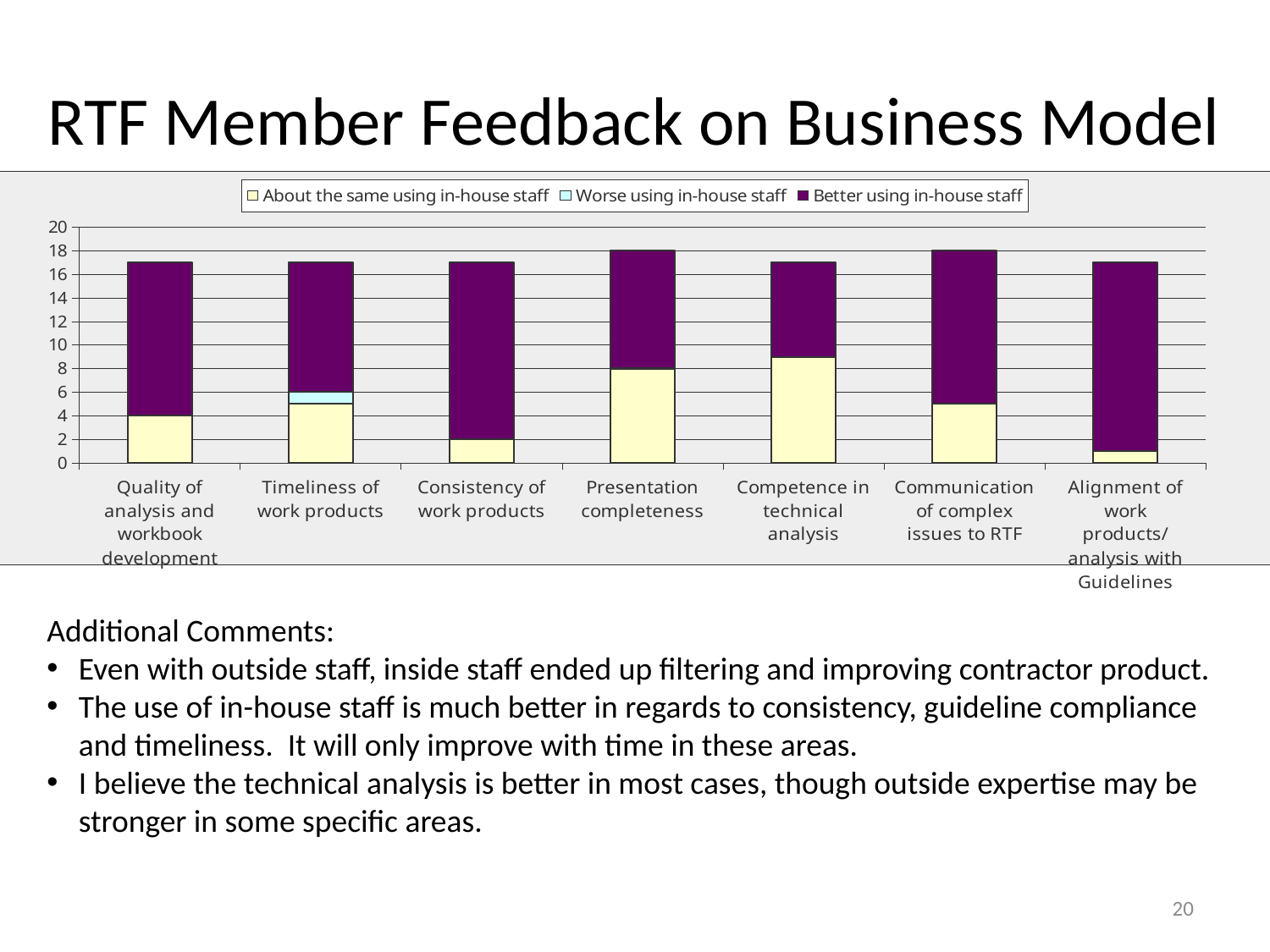
Which category has the lowest 'About the same using in-house staff' value? Alignment of work products/analysis with Guidelines Is the 'About the same using in-house staff' value for 'Competence in technical analysis' greater or less than 6? greater How many categories are shown along the x axis of the chart? 7 Which category is the only one with a 'Worse using in-house staff' segment? Timeliness of work products How many series does the chart legend list? 3 What type of chart is shown on the slide? Stacked bar chart What is the value of 'About the same using in-house staff' for 'Quality of analysis and workbook development'? 4 What is the value of 'About the same using in-house staff' for 'Consistency of work products'? 2 What is the total height of the stacked bar for 'Communication of complex issues to RTF'? 18 What is the value of 'About the same using in-house staff' for 'Presentation completeness'? 8 Which is larger: the 'About the same using in-house staff' value for 'Quality of analysis and workbook development' or for 'Presentation completeness'? Presentation completeness Is the 'About the same using in-house staff' value for 'Alignment of work products/analysis with Guidelines' greater or less than 2? less